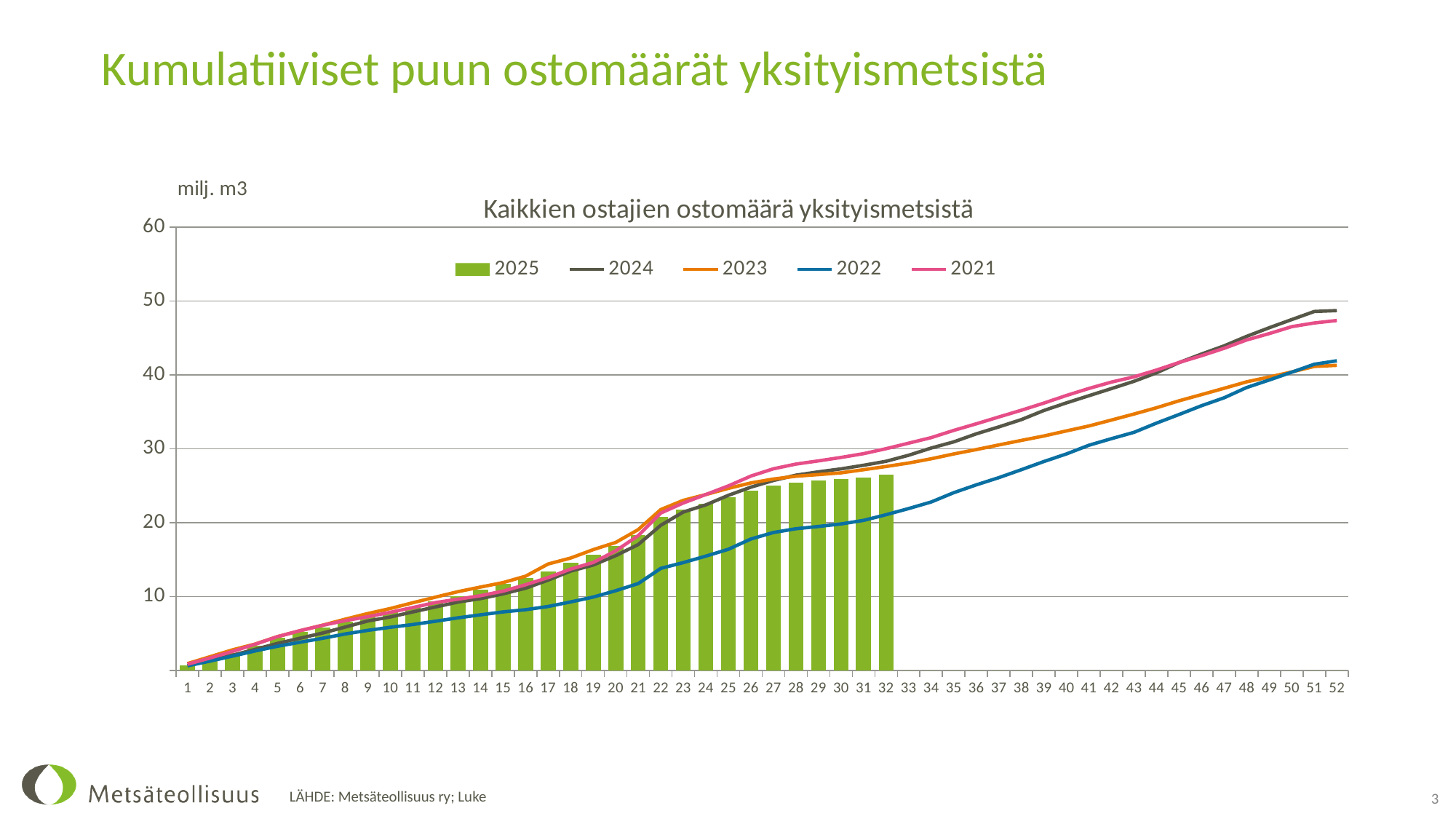
Is the value for 2022 at week 52 greater or less than 45? less At week 52, which is larger: the value for 2021 or the value for 2023? 2021 What is the title of the chart? Kaikkien ostajien ostomäärä yksityismetsistä Which series has the highest value at week 52? 2024 Is the value of the 2025 bar at week 32 greater or less than 30? less What kind of chart is this? Combined bar and line chart Do the values for the 2024 series rise or fall along the x axis? Rise Which series has the lowest value at week 32? 2022 How many series does the legend list? 5 Is the value for 2024 at week 52 greater or less than 40? greater What unit is shown on the vertical axis of the chart? milj. m3 How many week categories are shown on the x axis? 52